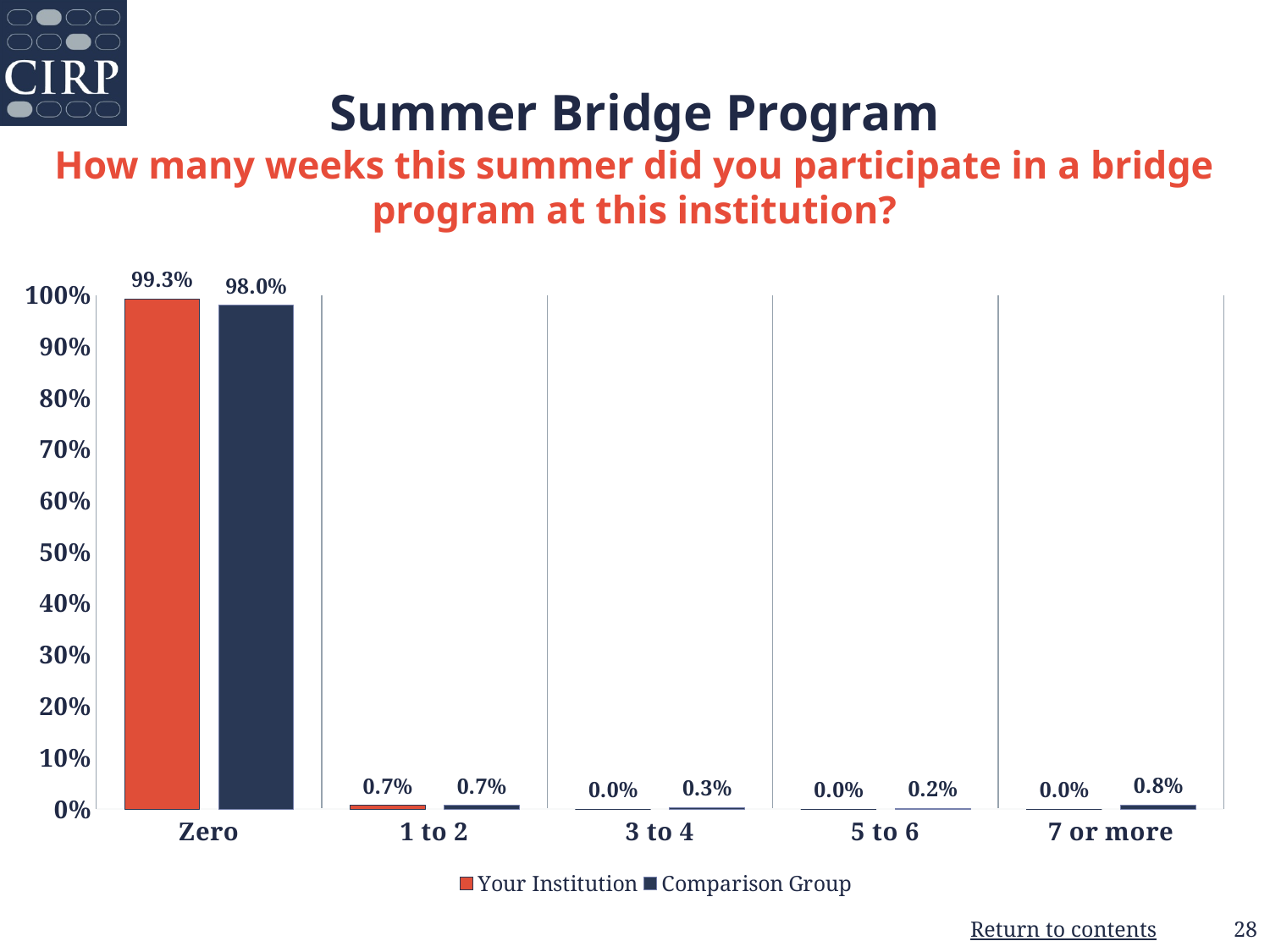
What kind of chart is shown on the slide? bar chart Which category has the highest value for Your Institution? Zero How many series does the legend list? 2 What is the value for Your Institution in the Zero category? 99.3% How many categories are shown on the x axis? 5 What is the value for Comparison Group in the Zero category? 98.0% Is the value for Comparison Group in the Zero category greater or less than 90%? greater Which is larger in the 5 to 6 category, Your Institution or Comparison Group? Comparison Group What is the value for Comparison Group in the 3 to 4 category? 0.3% What is the value for Your Institution in the 1 to 2 category? 0.7% What is the value for Comparison Group in the 7 or more category? 0.8% What is the difference between Your Institution and Comparison Group in the Zero category? 1.3%